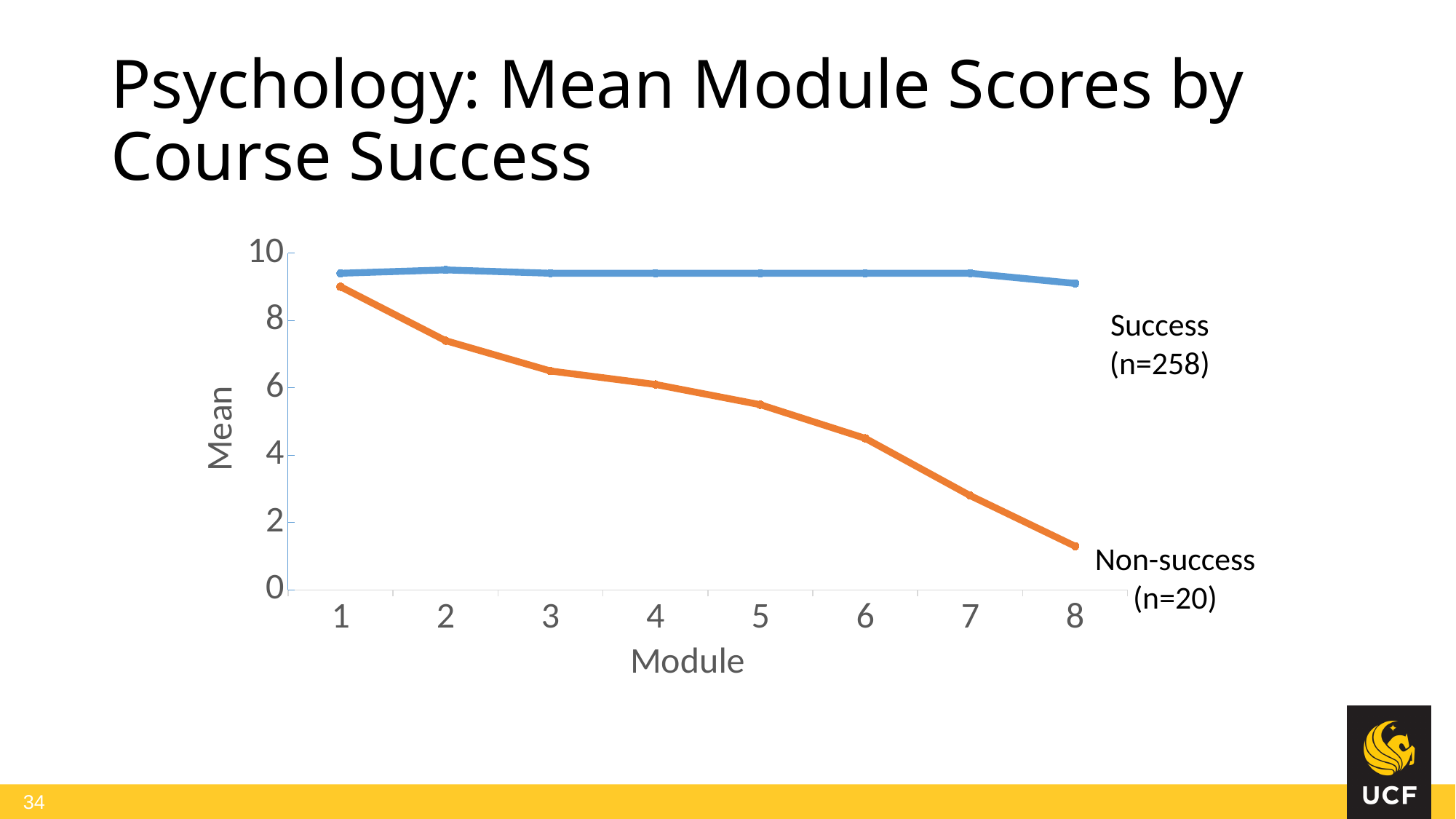
How many modules are plotted along the x axis? 8 At Module 8, which series has the higher mean score, Success or Non-success? Success Is the Non-success mean at Module 8 greater or less than 2? less What kind of chart is shown on the slide? line chart What is the sample size (n) shown for the Success group? 258 How many series are plotted on the chart? 2 Is the Non-success mean at Module 1 greater or less than 8? greater Does the Non-success line rise or fall from Module 1 to Module 8? fall At which module is the Non-success mean lowest? 8 Is the Non-success mean at Module 2 greater or less than 8? less At which module is the Non-success mean highest? 1